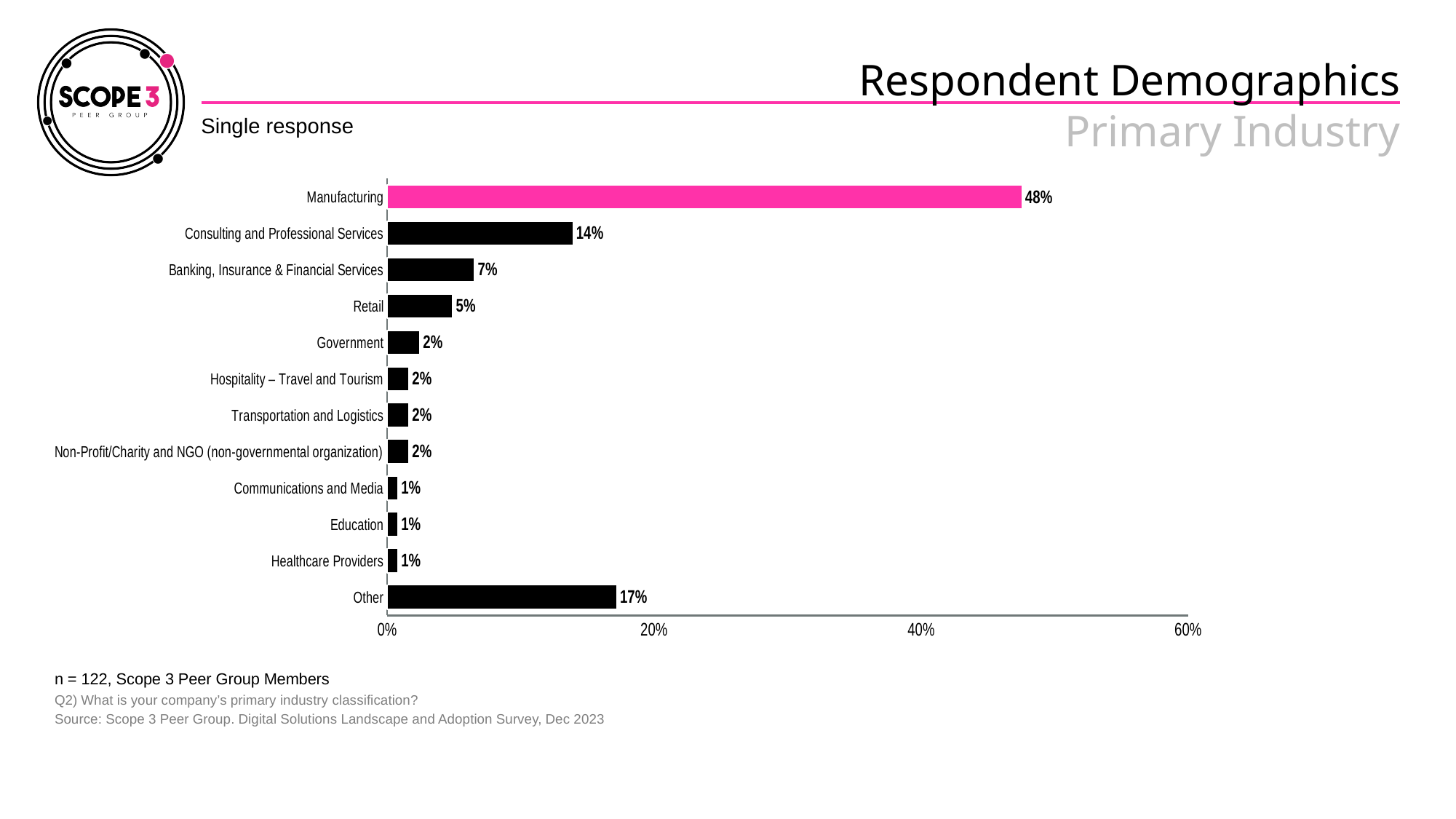
Is the value for Manufacturing greater or less than 40%? greater What is the value for Consulting and Professional Services? 14% What is the difference between the Manufacturing value and the Consulting and Professional Services value? 34% What is the value for Banking, Insurance & Financial Services? 7% What kind of chart is shown on the slide? Bar chart What percentage of respondents are in Manufacturing? 48% What percentage of respondents selected Other as their primary industry? 17% Which bar is highlighted in pink? Manufacturing Which industry has the highest share of respondents? Manufacturing How many industry categories are shown in the chart? 12 What is the value for Retail? 5% Which is larger, the value for Other or the value for Consulting and Professional Services? Other